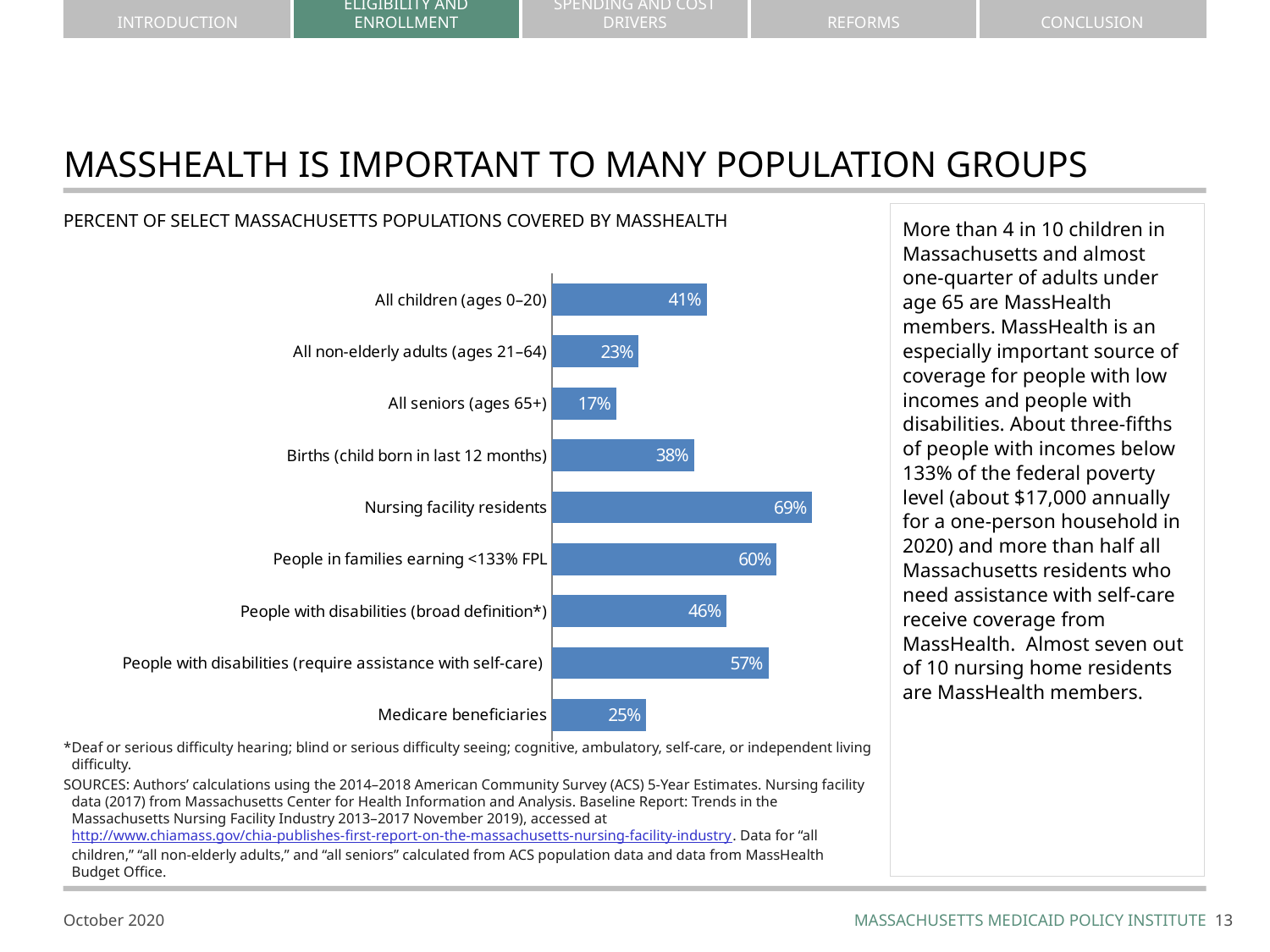
What is the value for Medicare beneficiaries? 25% What is the difference between the value for People with disabilities (require assistance with self-care) and People with disabilities (broad definition*)? 11% Which population group has the highest percent covered by MassHealth? Nursing facility residents What kind of chart is shown on the slide? Bar chart What is the value for People in families earning <133% FPL? 60% Which population group has the lowest percent covered by MassHealth? All seniors (ages 65+) What is the difference between the value for All non-elderly adults (ages 21–64) and All seniors (ages 65+)? 6% What is the title of the chart? Percent of select Massachusetts populations covered by MassHealth Which is larger: the value for All children (ages 0–20) or Births (child born in last 12 months)? All children (ages 0–20) What is the value for Nursing facility residents? 69% What percent of all children (ages 0–20) are covered by MassHealth? 41% How many population groups are shown in the chart? 9